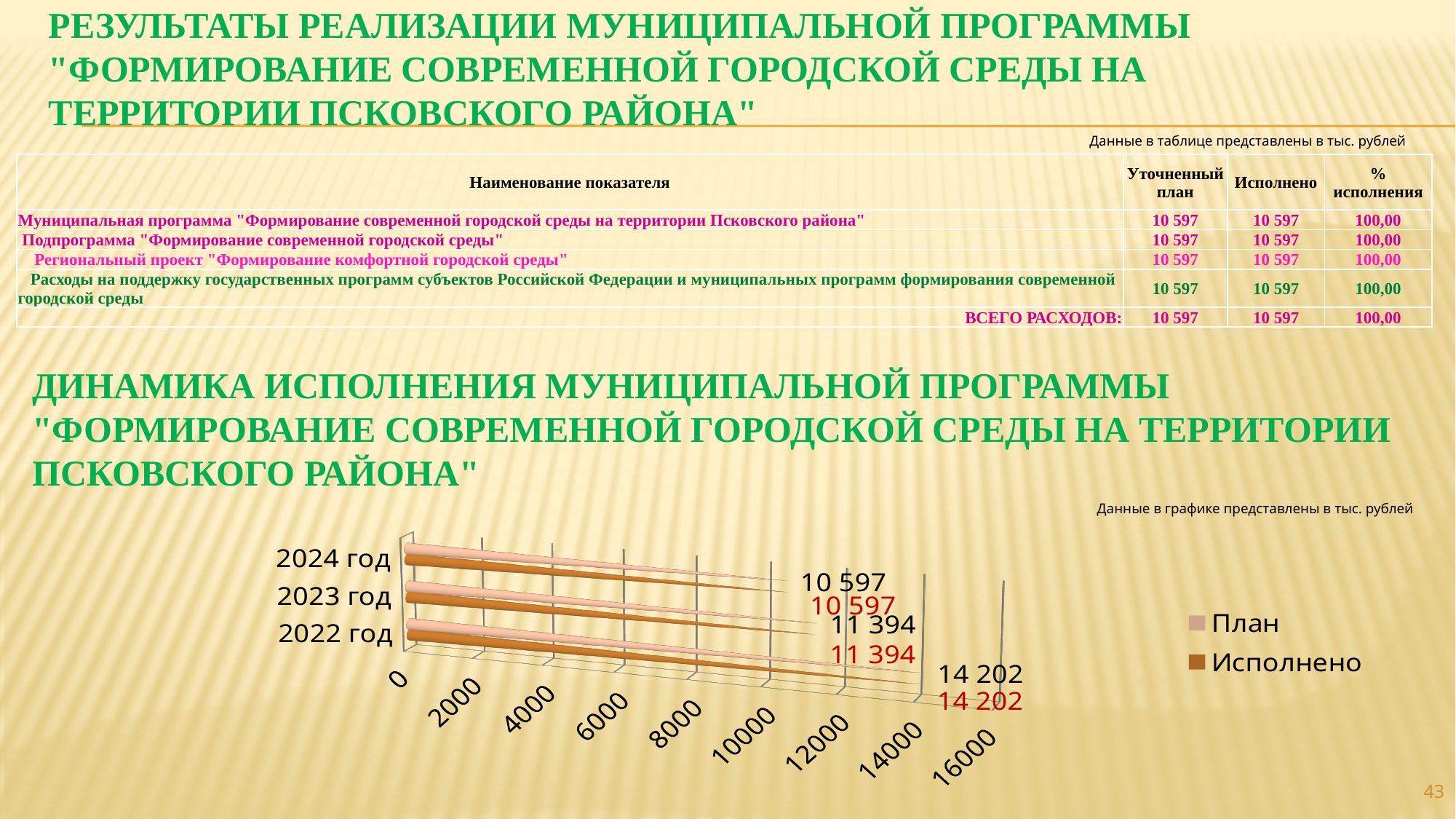
Which year has the lowest План value? 2024 год What is the difference between the Исполнено value for 2022 год and for 2024 год? 3 605 What kind of chart is shown on the slide? bar chart What is the Исполнено value for 2023 год? 11 394 Which year has the highest Исполнено value? 2022 год How many years (categories) are shown on the chart? 3 What is the План value for 2022 год? 14 202 Do the Исполнено values rise or fall from 2022 год to 2024 год? fall How many series does the chart legend list? 2 What are the series names in the chart legend? План, Исполнено What is the План value for 2024 год? 10 597 Which is larger: the План value for 2023 год or for 2024 год? 2023 год